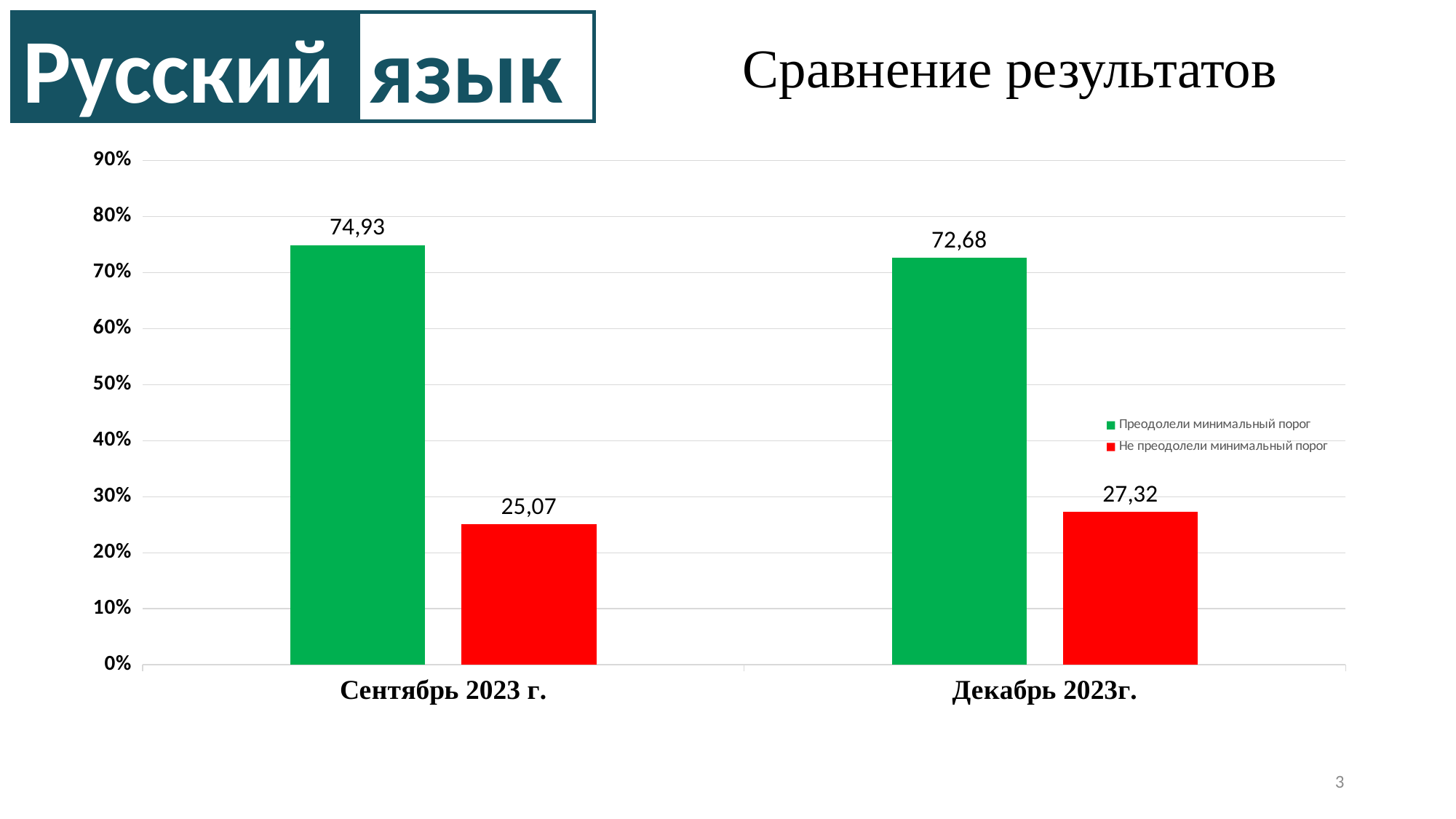
What kind of chart is shown on the slide? Bar chart What is the value for "Преодолели минимальный порог" in Сентябрь 2023 г.? 74,93 What is the difference between "Преодолели минимальный порог" and "Не преодолели минимальный порог" in Сентябрь 2023 г.? 49,86 What is the value for "Не преодолели минимальный порог" in Сентябрь 2023 г.? 25,07 By how much did the value for "Преодолели минимальный порог" change from Сентябрь 2023 г. to Декабрь 2023г.? 2,25 How many categories are shown on the x axis? 2 Which category has the lowest value for "Не преодолели минимальный порог"? Сентябрь 2023 г. Which is larger: "Не преодолели минимальный порог" in Сентябрь 2023 г. or in Декабрь 2023г.? Декабрь 2023г. How many series does the legend list? 2 What is the value for "Не преодолели минимальный порог" in Декабрь 2023г.? 27,32 What is the value for "Преодолели минимальный порог" in Декабрь 2023г.? 72,68 Which category has the highest value for "Преодолели минимальный порог"? Сентябрь 2023 г.